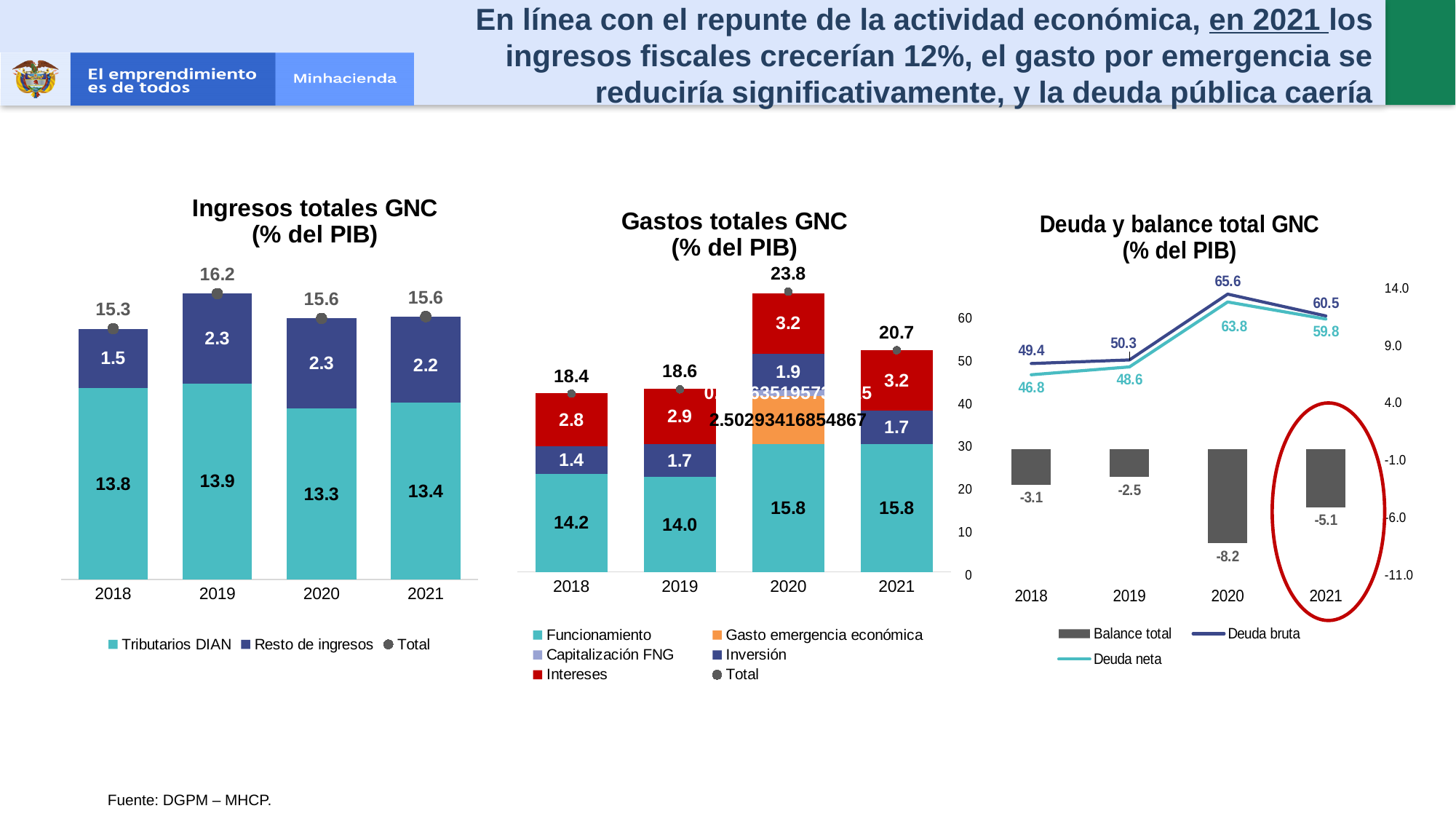
In the 'Deuda y balance total GNC' chart, what is the difference between Deuda bruta and Deuda neta in 2020? 1.8 In the 'Gastos totales GNC' chart, which year has the lowest total? 2018 In the 'Gastos totales GNC' chart, what is the Intereses value for 2019? 2.9 In the 'Ingresos totales GNC' chart, what is the difference between the Resto de ingresos values for 2019 and 2018? 0.8 In the 'Gastos totales GNC' chart, is the Funcionamiento value larger in 2018 or in 2020? 2020 In the 'Ingresos totales GNC' chart, how many series does the legend list? 3 In the 'Deuda y balance total GNC' chart, which year has the lowest Balance total? 2020 In the 'Deuda y balance total GNC' chart, what is the Deuda bruta value for 2021? 60.5 In the 'Deuda y balance total GNC' chart, how many years are shown on the x axis? 4 In the 'Gastos totales GNC' chart, what is the total for 2020? 23.8 In the 'Ingresos totales GNC' chart, what is the Tributarios DIAN value for 2020? 13.3 In the 'Ingresos totales GNC' chart, which year has the highest total? 2019